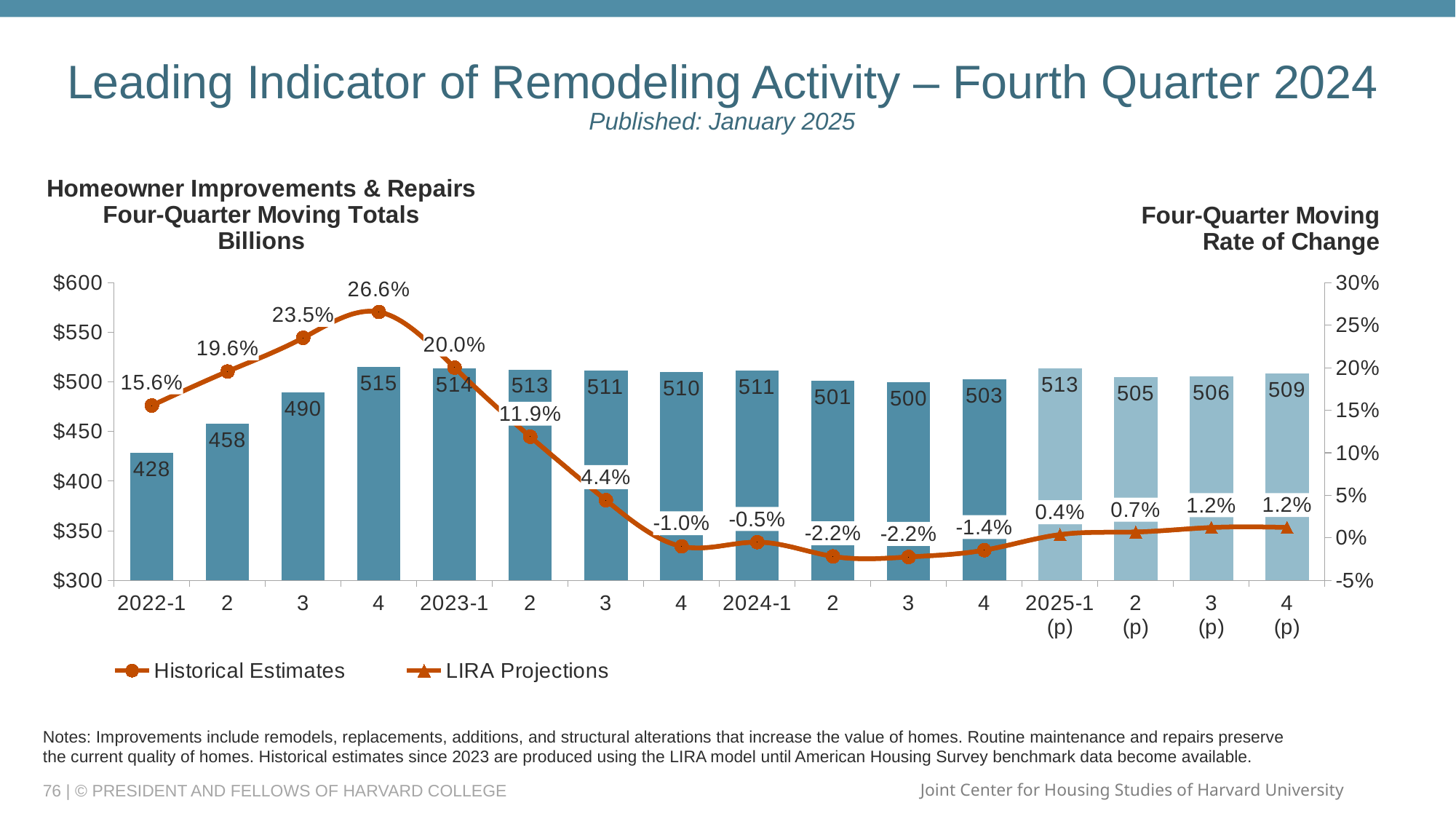
Does the four-quarter moving rate of change rise or fall from 2022-4 to 2024-2? fall What is the difference between the four-quarter moving totals for 2022-4 and 2022-1? 87 How many series does the legend list? 2 How many quarters are shown on the x axis? 16 What are the two entries in the chart legend? Historical Estimates and LIRA Projections What is the projected four-quarter moving total for 2025-4 (p)? 509 Which quarter has the lowest four-quarter moving total bar? 2022-1 What is the four-quarter moving total for 2022-1? 428 Which quarter has the highest four-quarter moving total bar? 2022-4 What is the four-quarter moving rate of change for 2023-2? 11.9% Which is larger, the four-quarter moving total for 2024-2 or for 2025-1 (p)? 2025-1 (p) Which quarter has the highest four-quarter moving rate of change? 2022-4